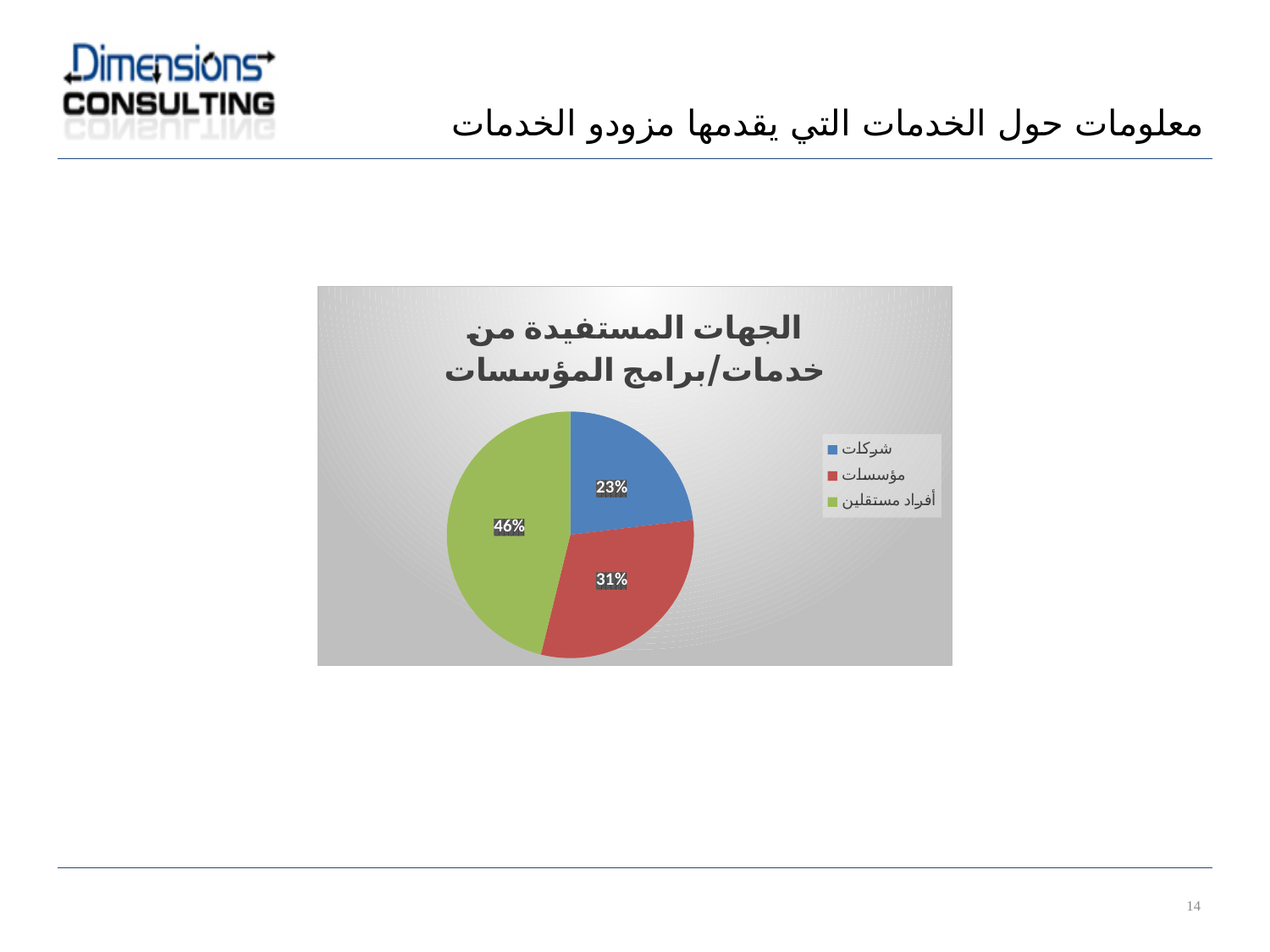
Which category has the smallest slice of the pie? شركات What share of the pie does أفراد مستقلين have? 46% What share of the pie does شركات have? 23% What colour is the slice for أفراد مستقلين? Green What share of the pie does مؤسسات have? 31% What kind of chart is shown on the slide? Pie chart What is the difference in percentage points between أفراد مستقلين and شركات? 23 What is the difference in percentage points between مؤسسات and شركات? 8 Which is larger, the slice for مؤسسات or the slice for شركات? مؤسسات Which category has the largest slice of the pie? أفراد مستقلين How many slices does the pie chart have? 3 How many entries does the legend list? 3